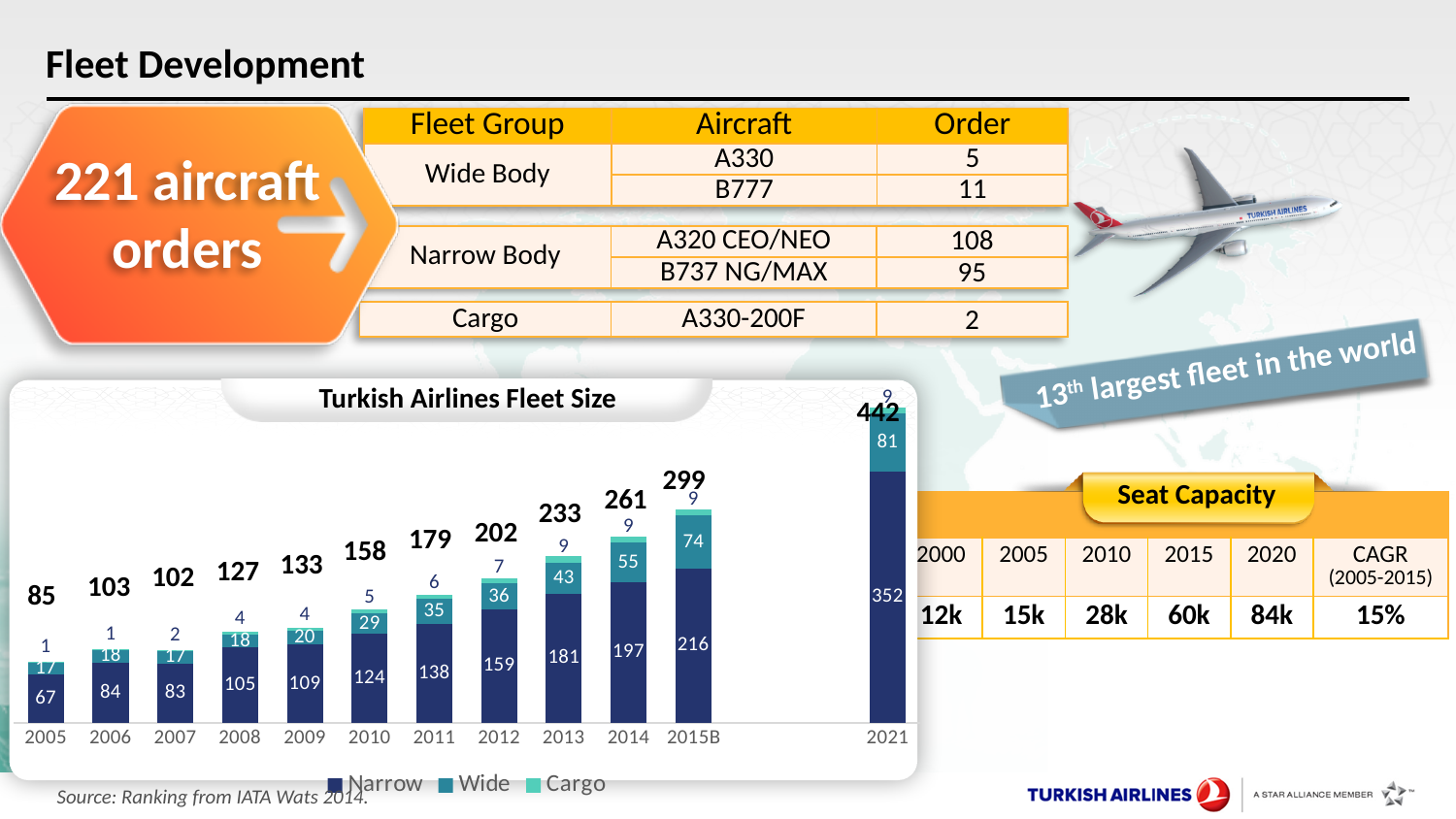
Does the total fleet size generally rise or fall from 2005 to 2021 in the Turkish Airlines Fleet Size chart? rise What is the Wide value for 2015B in the Turkish Airlines Fleet Size chart? 74 What is the Cargo value for 2010 in the Turkish Airlines Fleet Size chart? 5 What is the difference between the total fleet size in 2015B and in 2014 in the Turkish Airlines Fleet Size chart? 38 Which year has the lowest total fleet size in the Turkish Airlines Fleet Size chart? 2005 Which year has the highest total fleet size in the Turkish Airlines Fleet Size chart? 2021 How many series does the legend of the Turkish Airlines Fleet Size chart list? 3 What type of chart is the Turkish Airlines Fleet Size chart? stacked bar chart How many years (categories) are shown on the x axis of the Turkish Airlines Fleet Size chart? 12 What is the total fleet size shown for 2021 in the Turkish Airlines Fleet Size chart? 442 What is the Narrow value for 2012 in the Turkish Airlines Fleet Size chart? 159 In the Turkish Airlines Fleet Size chart, is the Narrow value larger in 2008 or in 2009? 2009